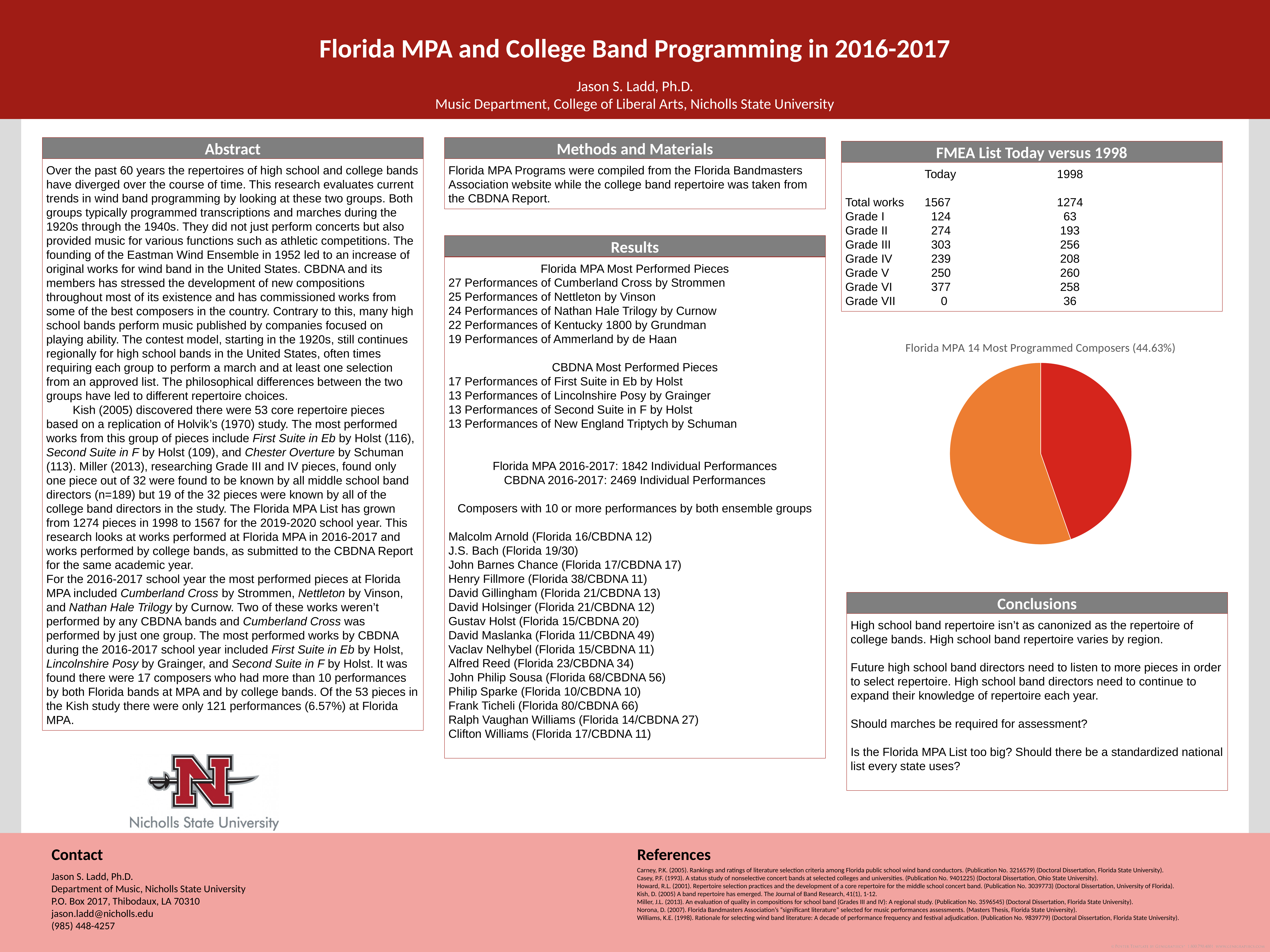
What percentage is stated in the title of the pie chart? 44.63% Which slice of the pie chart is larger, the red one or the orange one? orange What is the title of the pie chart? Florida MPA 14 Most Programmed Composers (44.63%) How many slices does the pie chart have? 2 Does the red slice of the pie chart cover more or less than half of the pie? less What kind of chart is shown on the slide? pie chart What two colours are used for the slices of the pie chart? red and orange